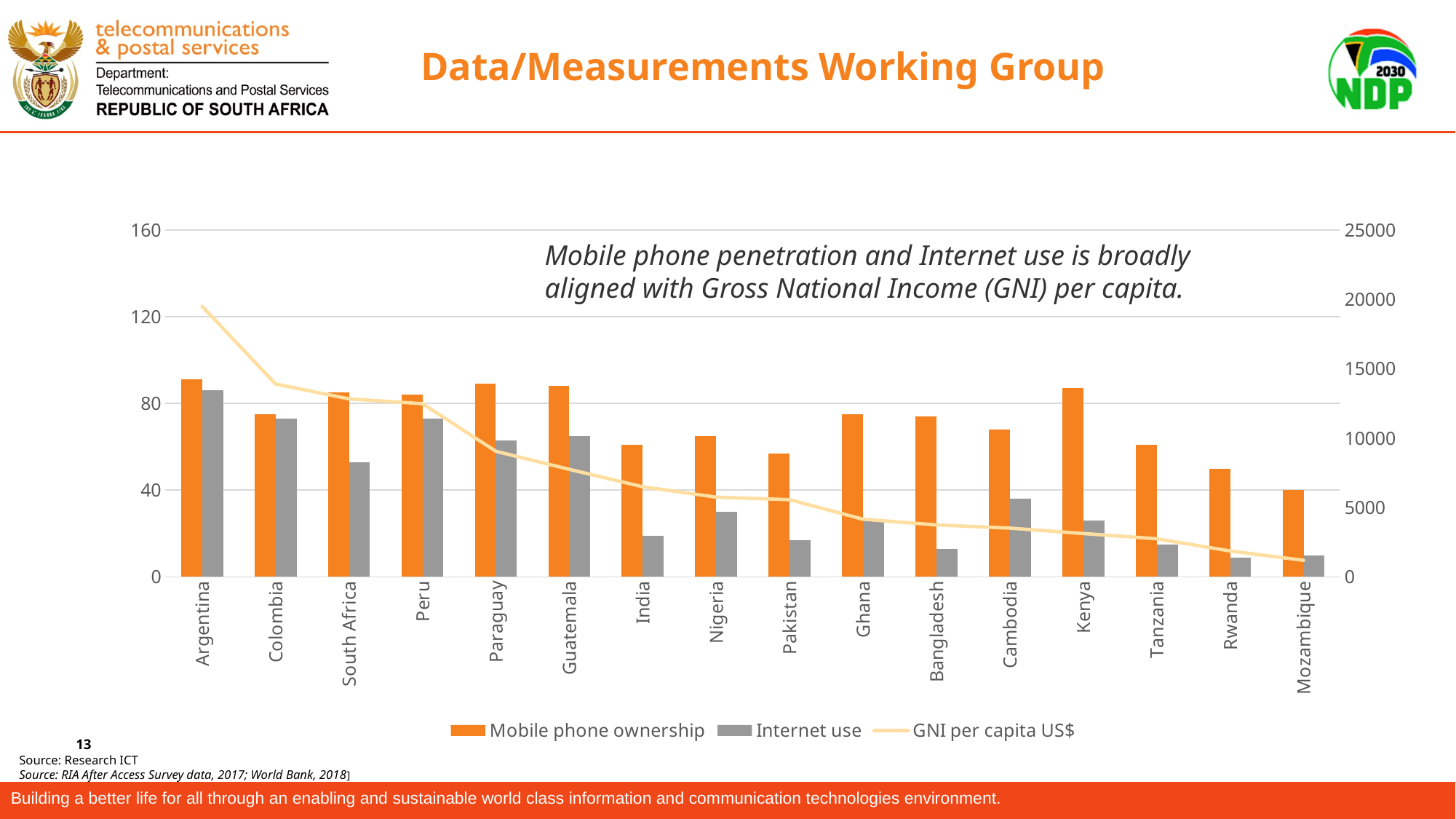
Is the Internet use value for South Africa greater or less than 40? greater Which country has the highest GNI per capita US$ value? Argentina Which country has the highest Internet use value? Argentina What type of chart is shown on the slide? Combined bar and line chart Is the GNI per capita US$ value for Argentina greater or less than 15000? greater How many series does the chart legend list? 3 Which series is plotted as a line in the chart? GNI per capita US$ How many countries are shown on the x axis of the chart? 16 Does the GNI per capita US$ line rise or fall from Argentina to Mozambique? Fall Is the Internet use value for India greater or less than 40? less Which country has the larger Internet use value, Cambodia or Ghana? Cambodia Which country has the lowest Mobile phone ownership value? Mozambique